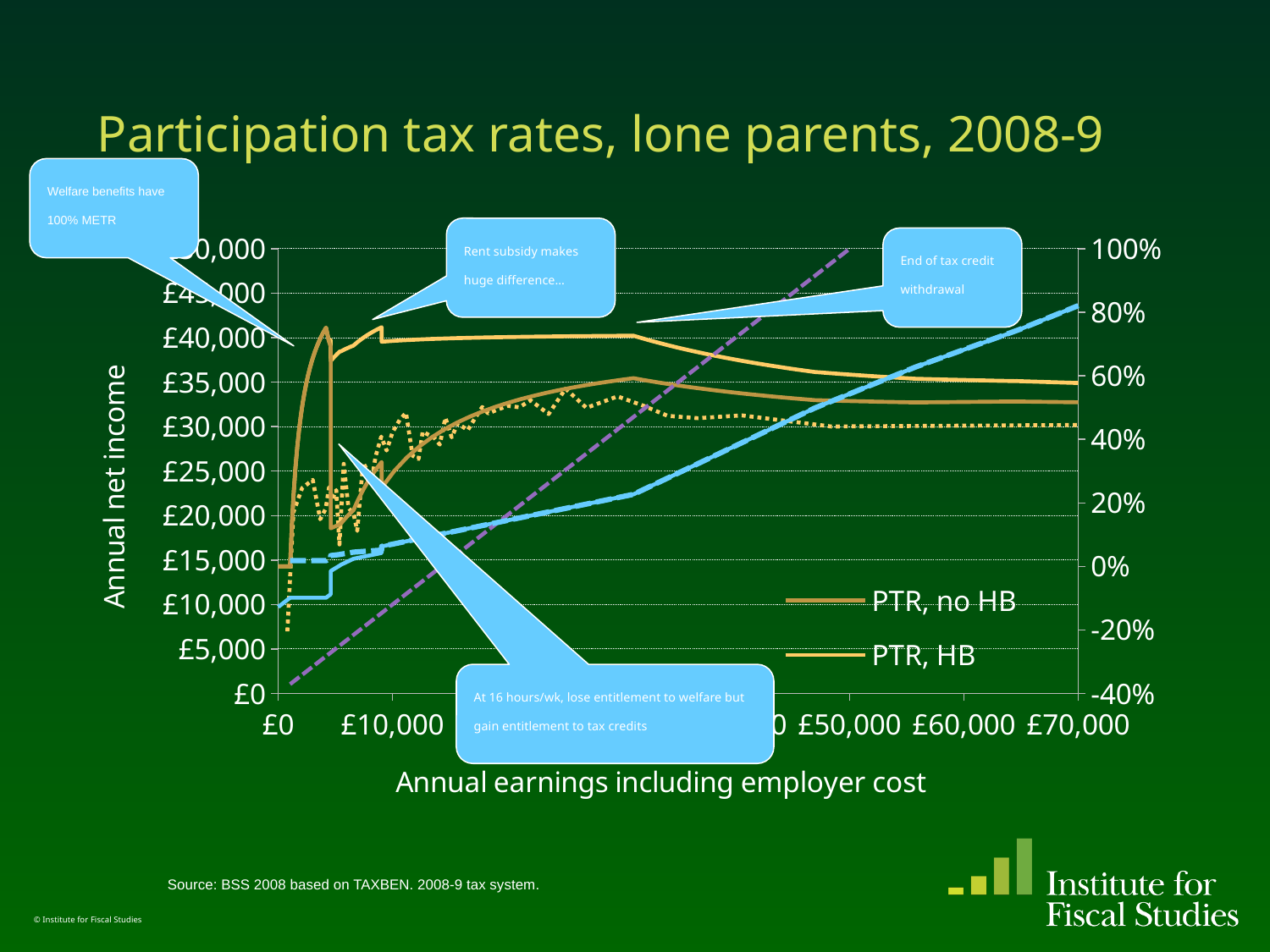
At £70,000 of annual earnings, which line is higher: PTR, HB or PTR, no HB? PTR, HB Does the PTR, HB line rise or fall as annual earnings increase from £40,000 to £70,000? Fall Is the value of the PTR, no HB line at £70,000 of annual earnings greater or less than 40%? greater Is the value of the PTR, HB line at £70,000 of annual earnings greater or less than 40%? greater What kind of chart is shown on the slide? Line chart What is the title of the chart? Participation tax rates, lone parents, 2008-9 Does the solid blue line rise or fall as annual earnings increase from £30,000 to £70,000? Rise Is the value of the PTR, no HB line at £70,000 of annual earnings greater or less than 60%? less How many series does the legend list? 2 What is the title of the x axis? Annual earnings including employer cost